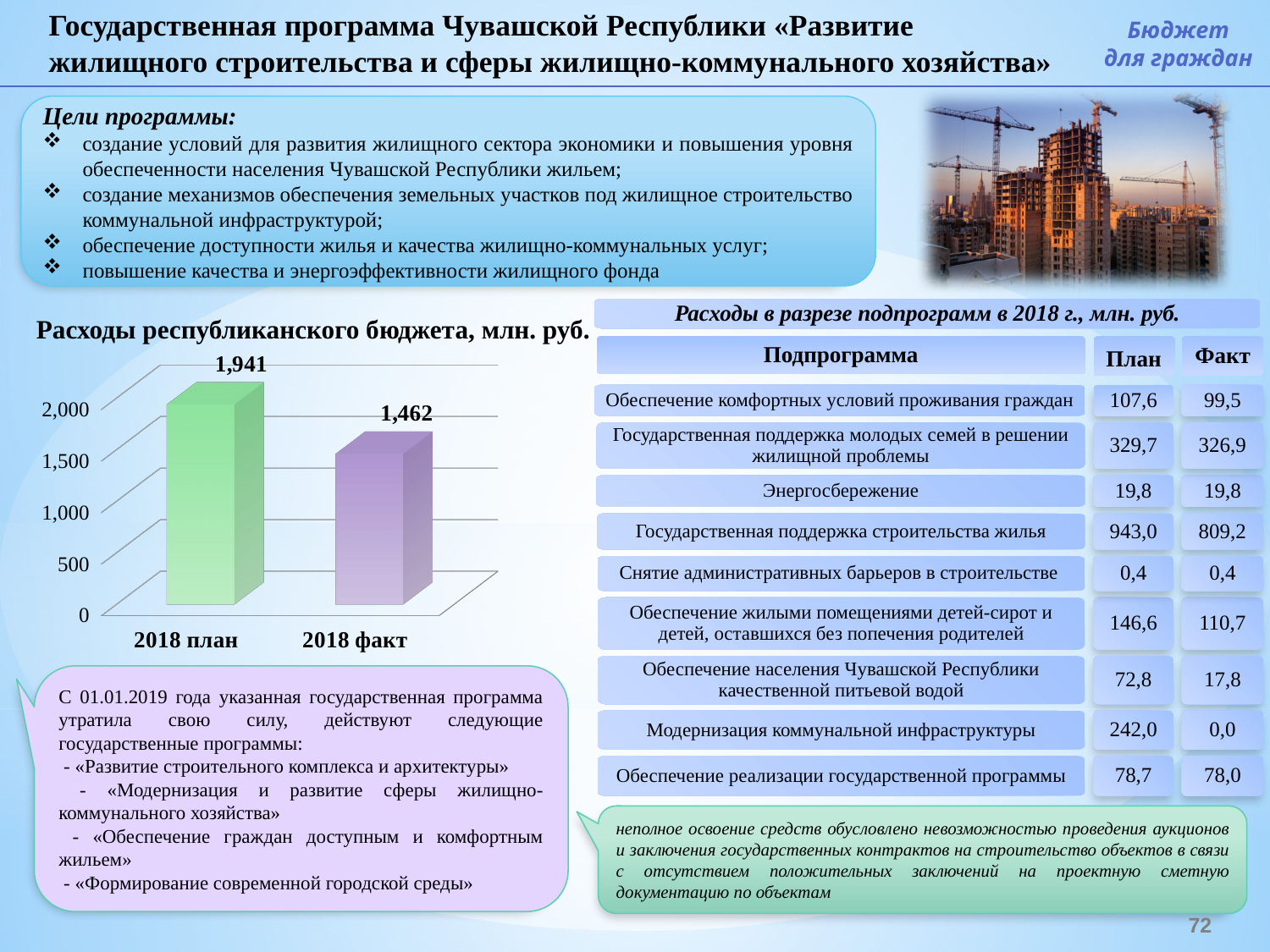
What is the value of the bar for 2018 факт in the chart «Расходы республиканского бюджета, млн. руб.»? 1,462 In the chart «Расходы республиканского бюджета, млн. руб.», is the value for 2018 факт greater or less than 1,500? less What kind of chart is «Расходы республиканского бюджета, млн. руб.»? bar chart What is the difference between the 2018 план and 2018 факт values in the chart «Расходы республиканского бюджета, млн. руб.»? 479 Which category has the highest value in the chart «Расходы республиканского бюджета, млн. руб.»? 2018 план What is the value of the bar for 2018 план in the chart «Расходы республиканского бюджета, млн. руб.»? 1,941 In the chart «Расходы республиканского бюджета, млн. руб.», which is larger: 2018 план or 2018 факт? 2018 план Which category has the lowest value in the chart «Расходы республиканского бюджета, млн. руб.»? 2018 факт What is the title of the bar chart on the slide? Расходы республиканского бюджета, млн. руб. How many bars are shown in the chart «Расходы республиканского бюджета, млн. руб.»? 2 In the chart «Расходы республиканского бюджета, млн. руб.», do the values rise or fall from 2018 план to 2018 факт? fall In the chart «Расходы республиканского бюджета, млн. руб.», is the value for 2018 план greater or less than 1,500? greater